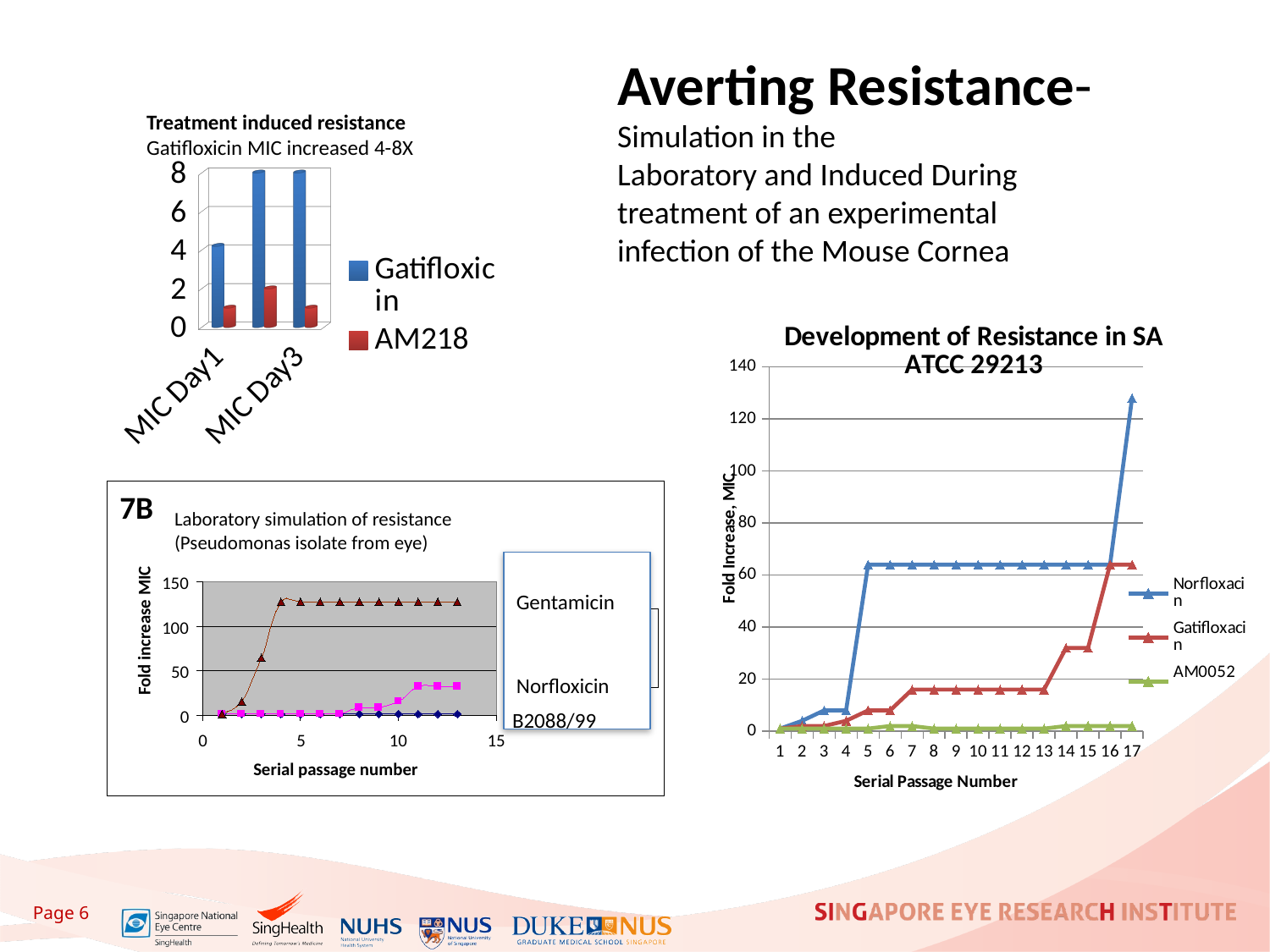
In the 'Treatment induced resistance' chart, is the Gatifloxicin value at MIC Day1 greater or less than 2? greater In the 'Development of Resistance in SA ATCC 29213' chart, which series reaches the highest fold increase in MIC? Norfloxacin How many serial passage numbers are shown on the x axis of the 'Development of Resistance in SA ATCC 29213' chart? 17 What is the title of the line chart on the right side of the slide? Development of Resistance in SA ATCC 29213 How many series does the legend of the 'Development of Resistance in SA ATCC 29213' chart list? 3 In the 'Treatment induced resistance' chart, is the AM218 value at MIC Day1 greater or less than 2? less In the 'Development of Resistance in SA ATCC 29213' chart, which series stays lowest across all serial passages? AM0052 In the 'Development of Resistance in SA ATCC 29213' chart, is the Norfloxacin value at serial passage 17 greater or less than 120? greater What type of chart is the 'Treatment induced resistance' chart at the top left of the slide? bar chart How many series does the legend of the 'Treatment induced resistance' chart list? 2 In the 'Treatment induced resistance' chart, which series has the taller bar at MIC Day3, Gatifloxicin or AM218? Gatifloxicin